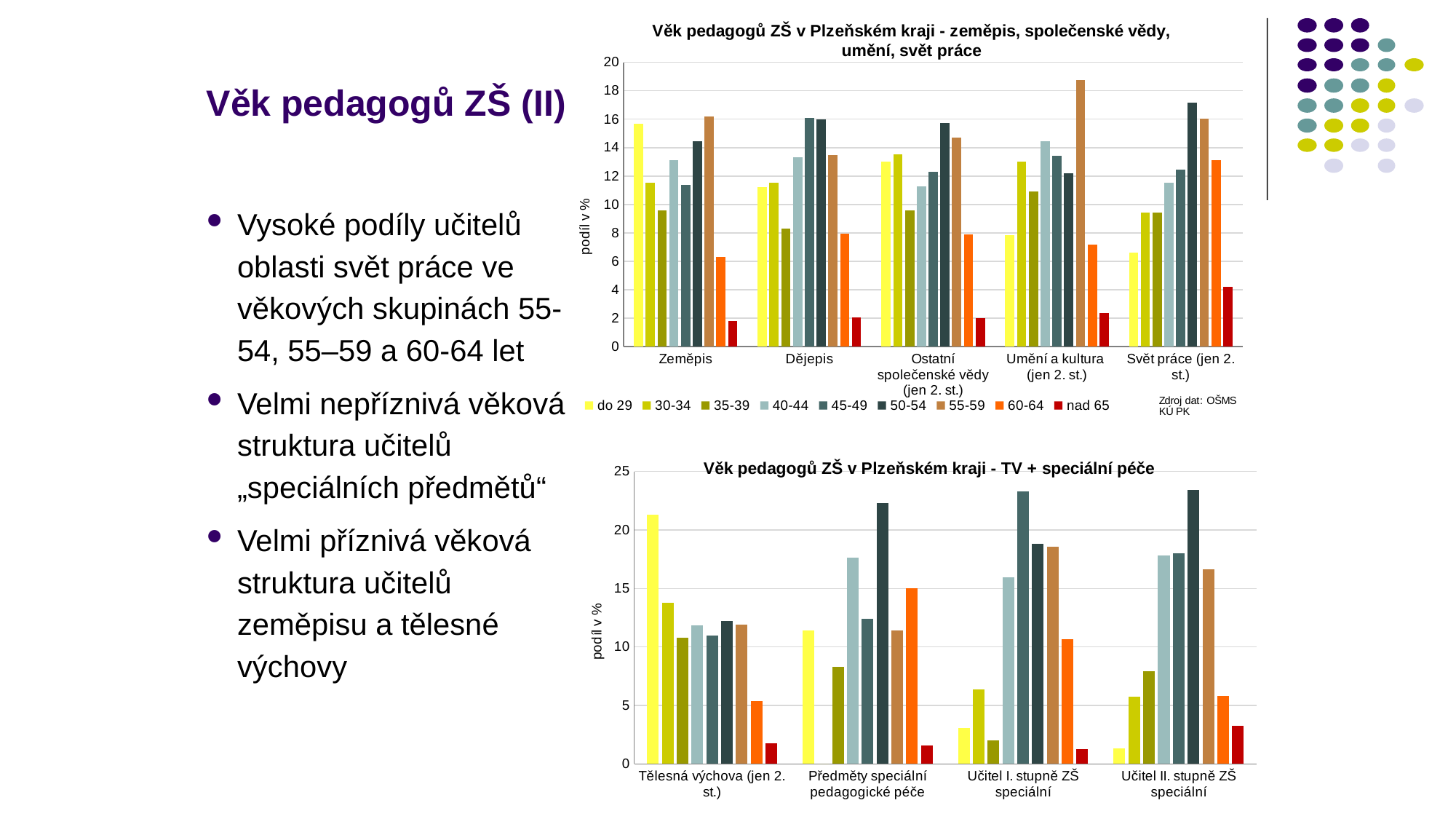
In the top chart, is the value for 'do 29' in Zeměpis greater or less than 14? greater In the top chart, is the value for '55-59' in Umění a kultura (jen 2. st.) greater or less than 16? greater In the top chart, is the value for 'nad 65' in Svět práce (jen 2. st.) greater or less than 6? less How many categories are shown on the x axis of the top chart? 5 How many categories are shown on the x axis of the bottom chart, 'Věk pedagogů ZŠ v Plzeňském kraji - TV + speciální péče'? 4 In the top chart, which category has the highest value for the 'do 29' series? Zeměpis In the bottom chart, which category has the tallest yellow (first) bar? Tělesná výchova (jen 2. st.) How many series does the legend of the top chart list? 9 What is the label of the y axis on the bottom chart? podíl v % What kind of chart is the top chart, 'Věk pedagogů ZŠ v Plzeňském kraji - zeměpis, společenské vědy, umění, svět práce'? Bar chart In the bottom chart, is the yellow (first) bar larger for Tělesná výchova (jen 2. st.) or for Učitel II. stupně ZŠ speciální? Tělesná výchova (jen 2. st.)